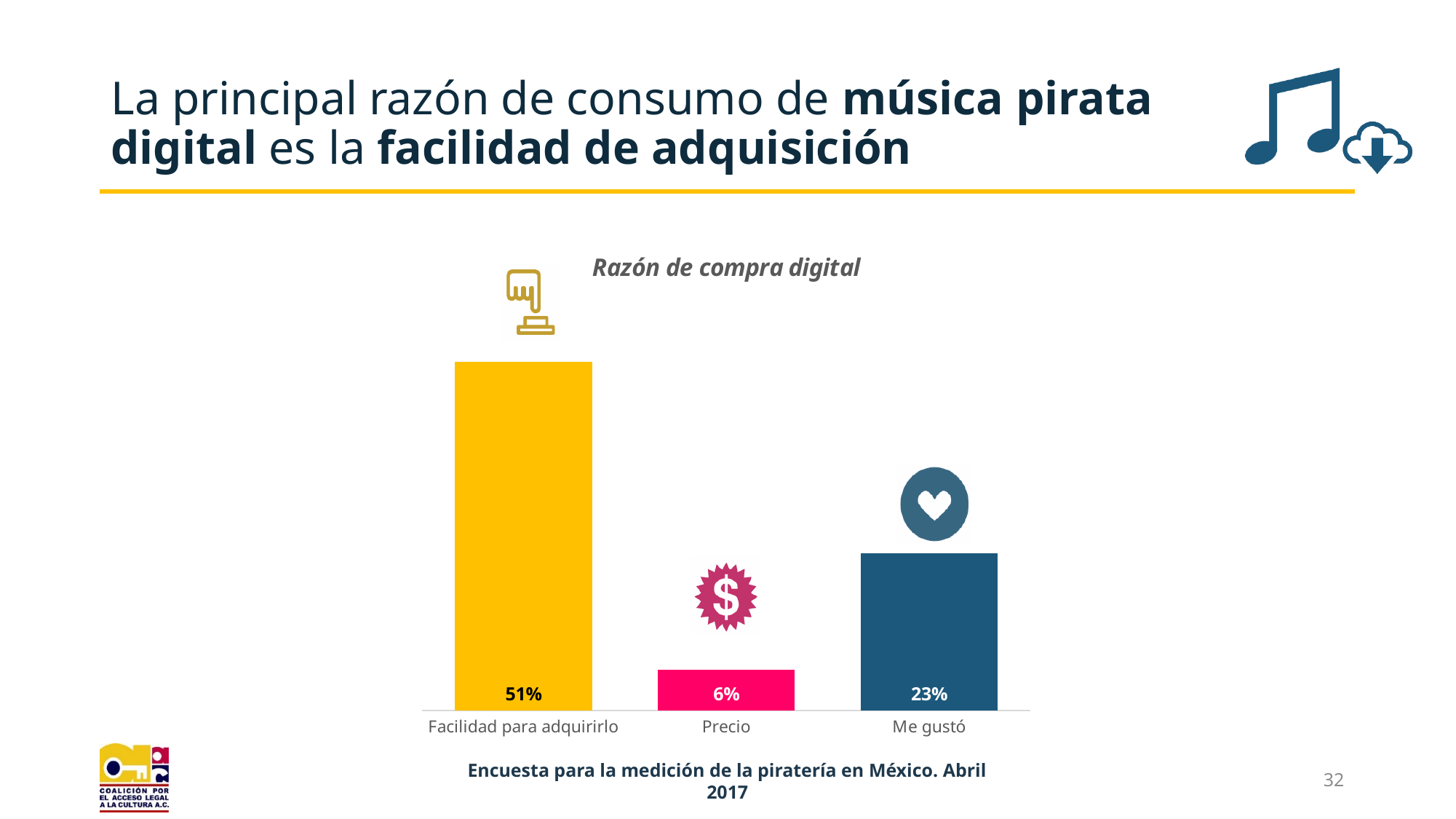
What is the value for Me gustó? 23% Which category has the lowest value? Precio What is the value for Precio? 6% Which category has the highest value? Facilidad para adquirirlo What is the title of the chart? Razón de compra digital What kind of chart is shown on the slide? Bar chart What is the difference between the values for Facilidad para adquirirlo and Me gustó? 28% What colour is the bar for Precio? Pink What is the value for Facilidad para adquirirlo? 51% Which is larger, the value for Me gustó or the value for Precio? Me gustó What is the difference between the values for Me gustó and Precio? 17% How many categories are shown in the chart? 3